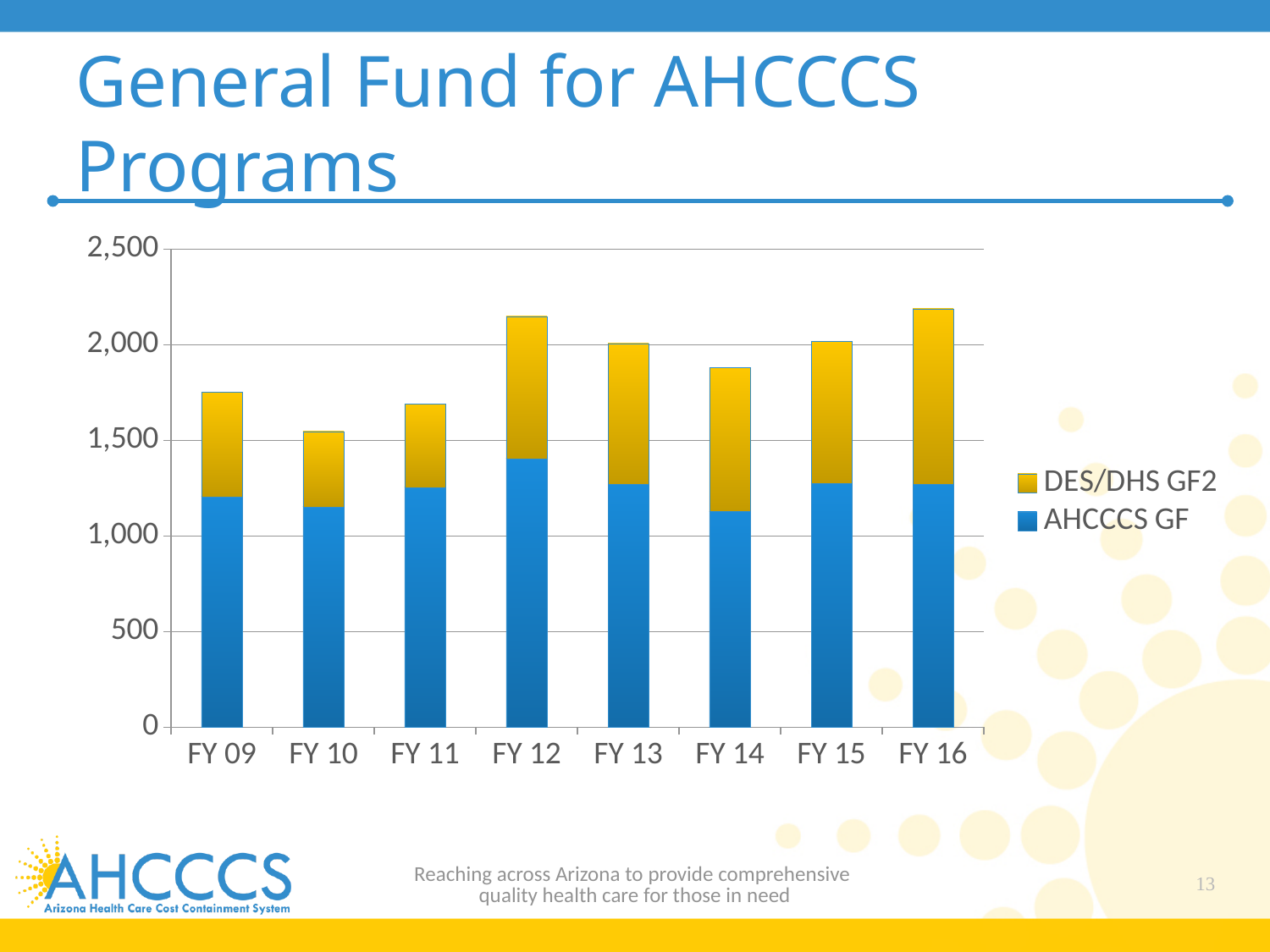
Which fiscal year has the lowest total General Fund bar? FY 10 What is the title of the slide containing the chart? General Fund for AHCCCS Programs How many series does the chart's legend list? 2 How many fiscal years are shown on the x axis of the chart? 8 Is the total bar for FY 12 greater or less than 2,000? greater Which has the larger total bar, FY 12 or FY 10? FY 12 Is the AHCCCS GF segment for FY 12 greater or less than 1,000? greater Is the total bar for FY 14 greater or less than 2,000? less Which series is shown in yellow in the chart? DES/DHS GF2 What kind of chart is shown on the slide? Stacked bar chart Which fiscal year has the tallest AHCCCS GF (blue) segment? FY 12